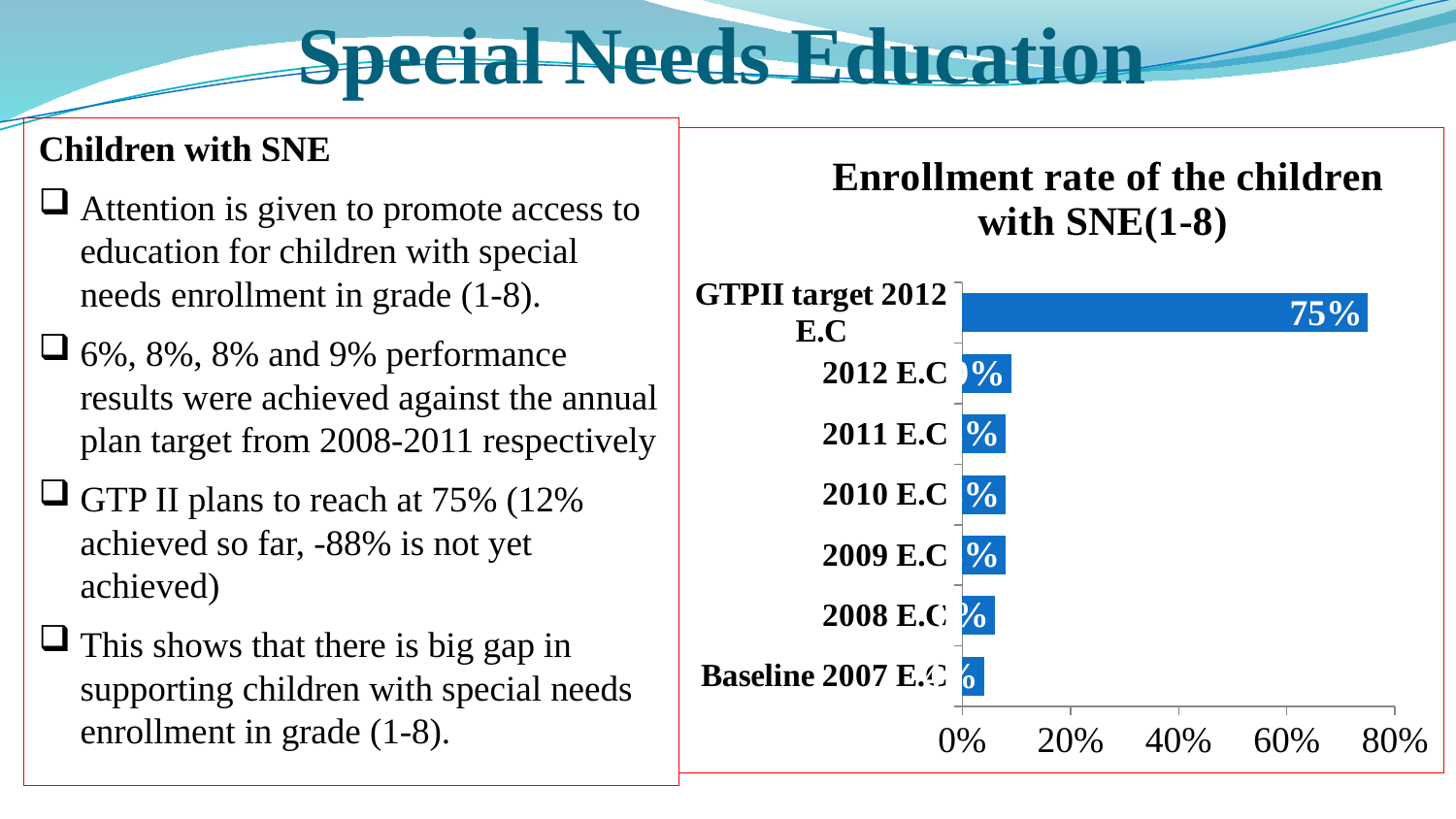
Which is larger, the value for GTPII target 2012 E.C or the value for 2011 E.C? GTPII target 2012 E.C How many categories are plotted in the chart? 7 Which is larger, the value for 2009 E.C or the value for Baseline 2007 E.C? 2009 E.C What kind of chart is shown on the slide? Bar chart Is the value for 2010 E.C greater or less than 40%? less Which category has the lowest value in the chart? Baseline 2007 E.C What is the value for GTPII target 2012 E.C in the chart? 75% Is the value for GTPII target 2012 E.C greater or less than 60%? greater What is the highest value shown on the chart's horizontal axis? 80% Which category has the highest value in the chart? GTPII target 2012 E.C What is the title of the chart? Enrollment rate of the children with SNE(1-8) Is the value for 2012 E.C greater or less than 20%? less